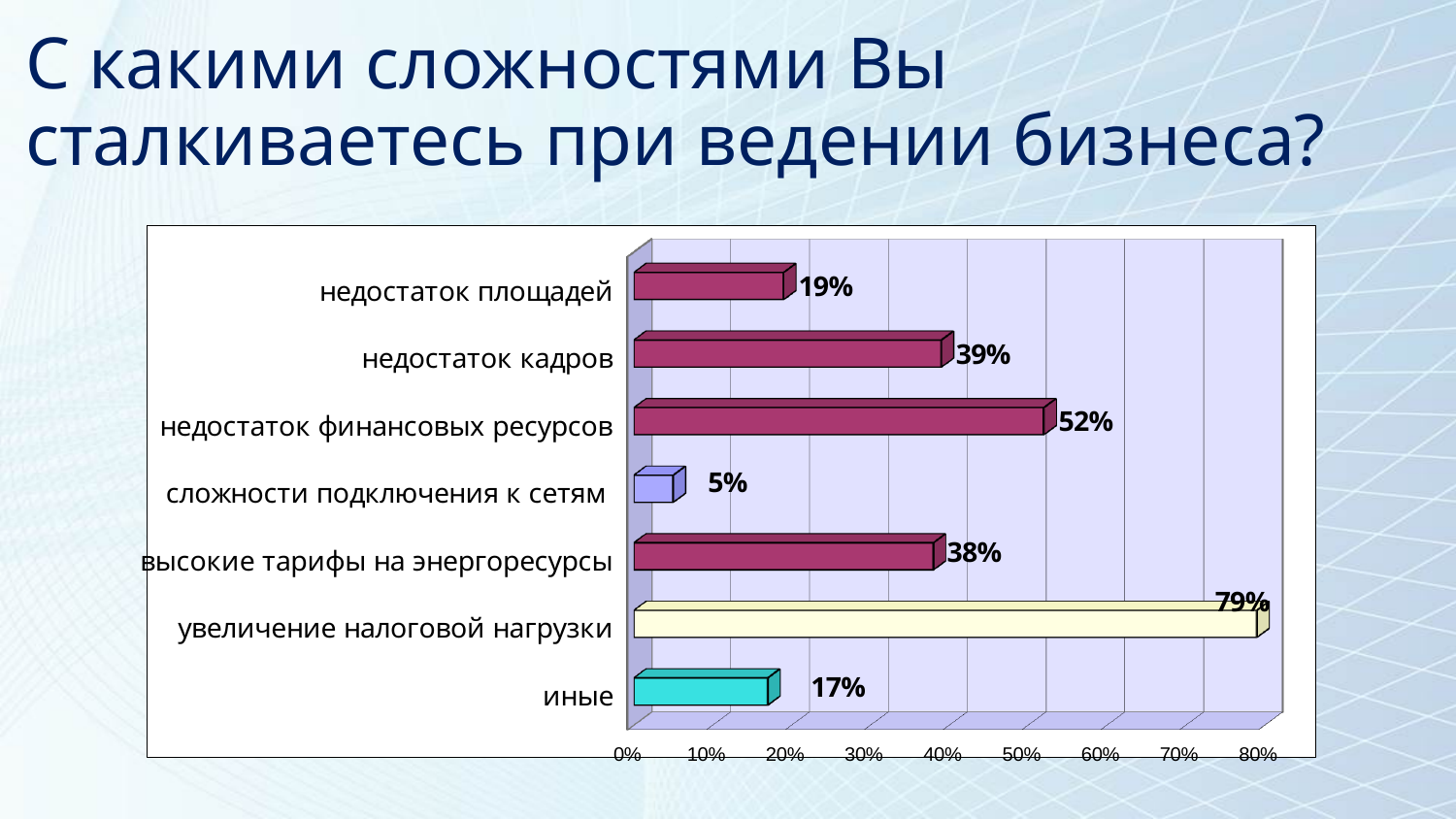
Which category has the highest value? увеличение налоговой нагрузки How many categories are shown in the chart? 7 What is the value for сложности подключения к сетям? 5% What is the difference between the values for увеличение налоговой нагрузки and недостаток финансовых ресурсов? 27% What is the value for недостаток площадей? 19% Which category has the lowest value? сложности подключения к сетям Which is larger, the value for недостаток кадров or the value for высокие тарифы на энергоресурсы? недостаток кадров What kind of chart is shown on the slide? bar chart What is the value for недостаток финансовых ресурсов? 52% Is the value for недостаток кадров greater or less than 30%? greater What is the title of the slide? С какими сложностями Вы сталкиваетесь при ведении бизнеса? What is the value for иные? 17%